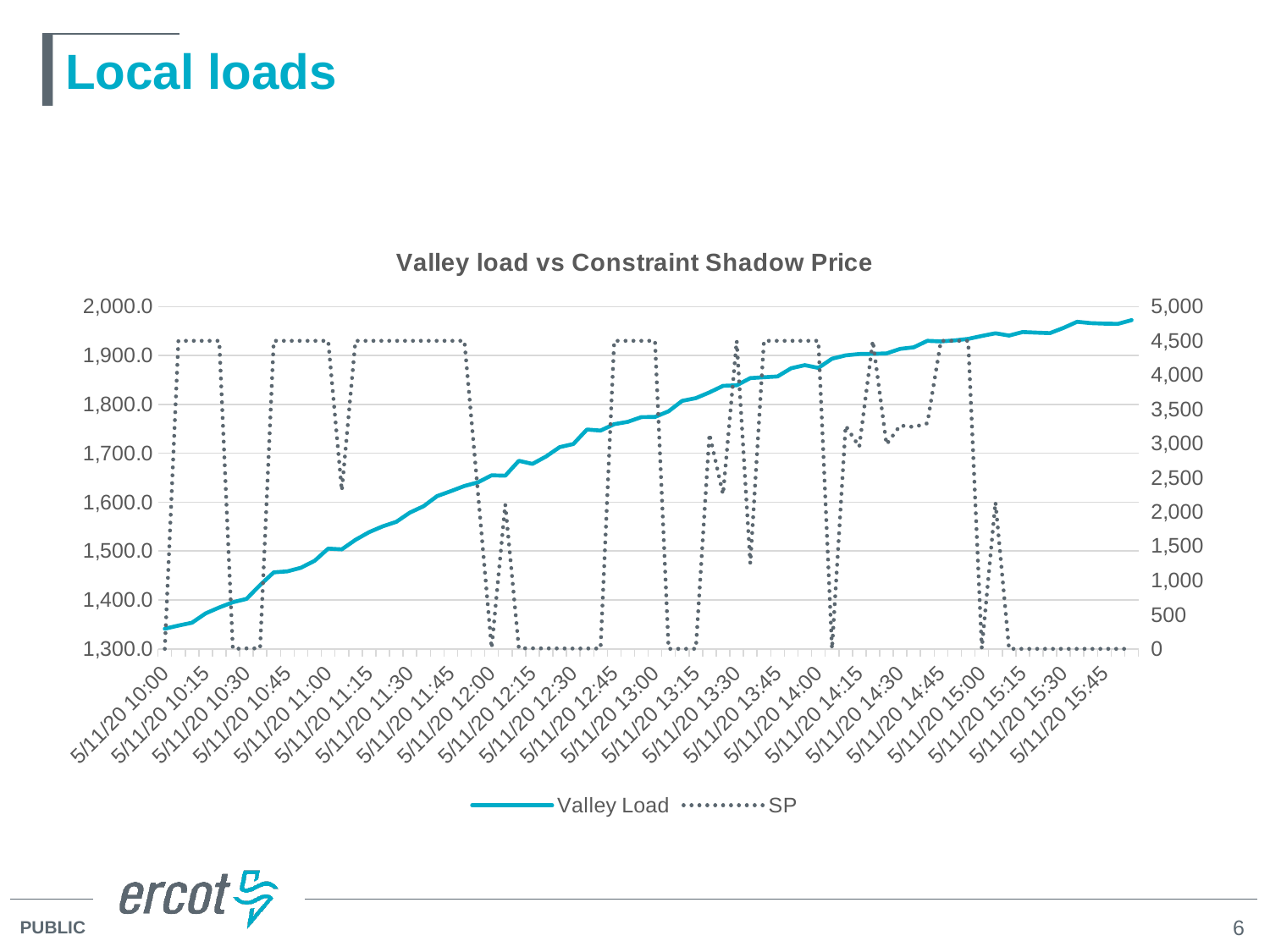
Is the SP value at 5/11/20 10:15 greater or less than 4,000? greater How many time labels are shown on the x axis? 24 Which is larger, the Valley Load value at 5/11/20 15:30 or at 5/11/20 10:30? 5/11/20 15:30 How many series does the legend list? 2 Is the Valley Load value at 5/11/20 15:45 greater or less than 1,900.0? greater What is the title of the chart? Valley load vs Constraint Shadow Price Which series is drawn with a dotted line? SP Is the Valley Load value at 5/11/20 10:00 greater or less than 1,400.0? less What kind of chart is shown on the slide? Line chart Does the Valley Load series generally rise or fall from 10:00 to 15:45? Rise